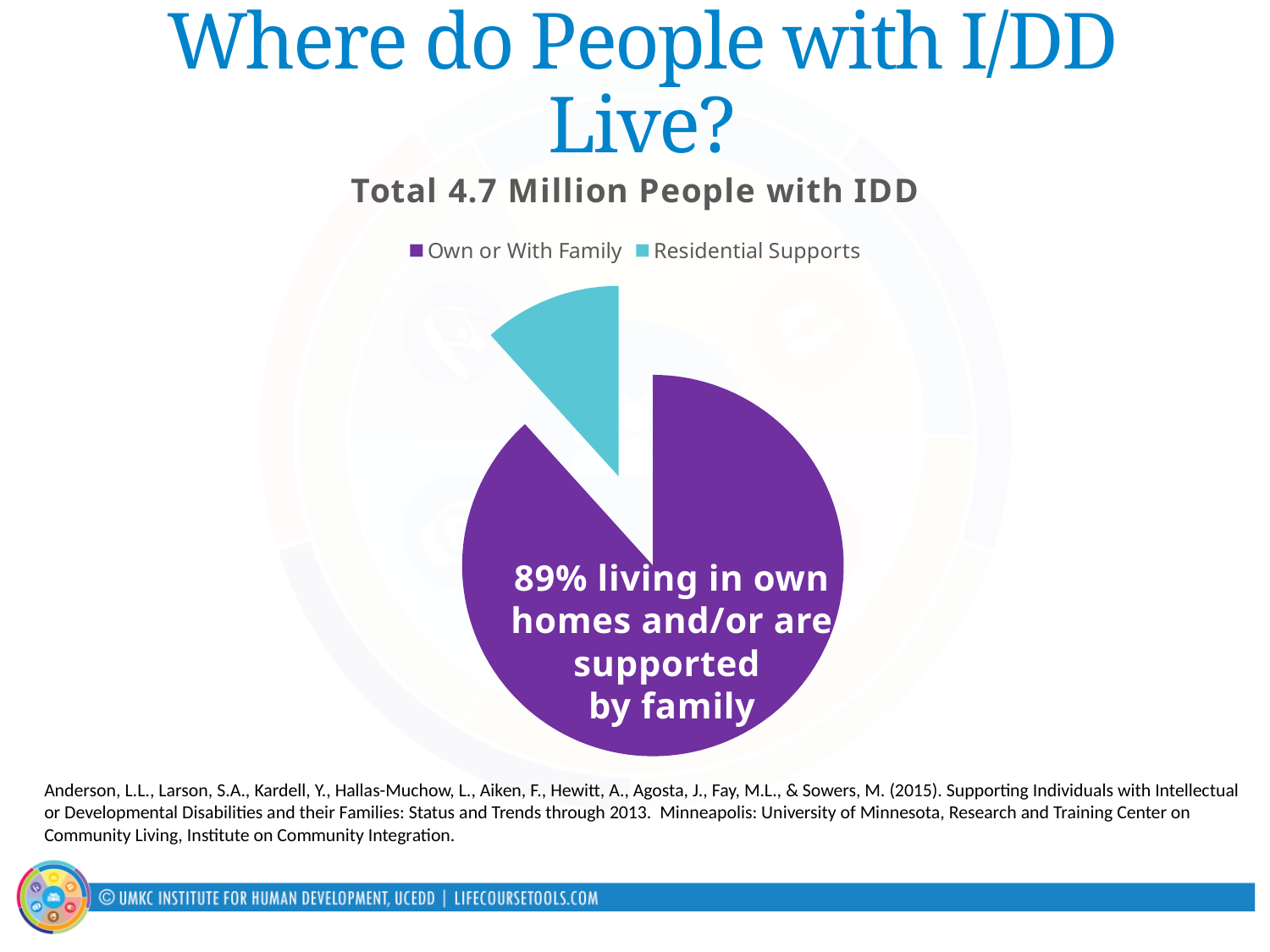
Which category has the smallest slice of the pie? Residential Supports What share of the pie is the Own or With Family slice? 89% How many slices does the pie chart have? 2 What kind of chart is shown on the slide? Pie chart What is the title of the pie chart? Total 4.7 Million People with IDD What colour is the Residential Supports slice? Teal (light blue) Which slice is larger, Own or With Family or Residential Supports? Own or With Family Which category has the largest slice of the pie? Own or With Family What percentage is printed on the purple slice of the pie? 89% How many entries does the chart legend list? 2